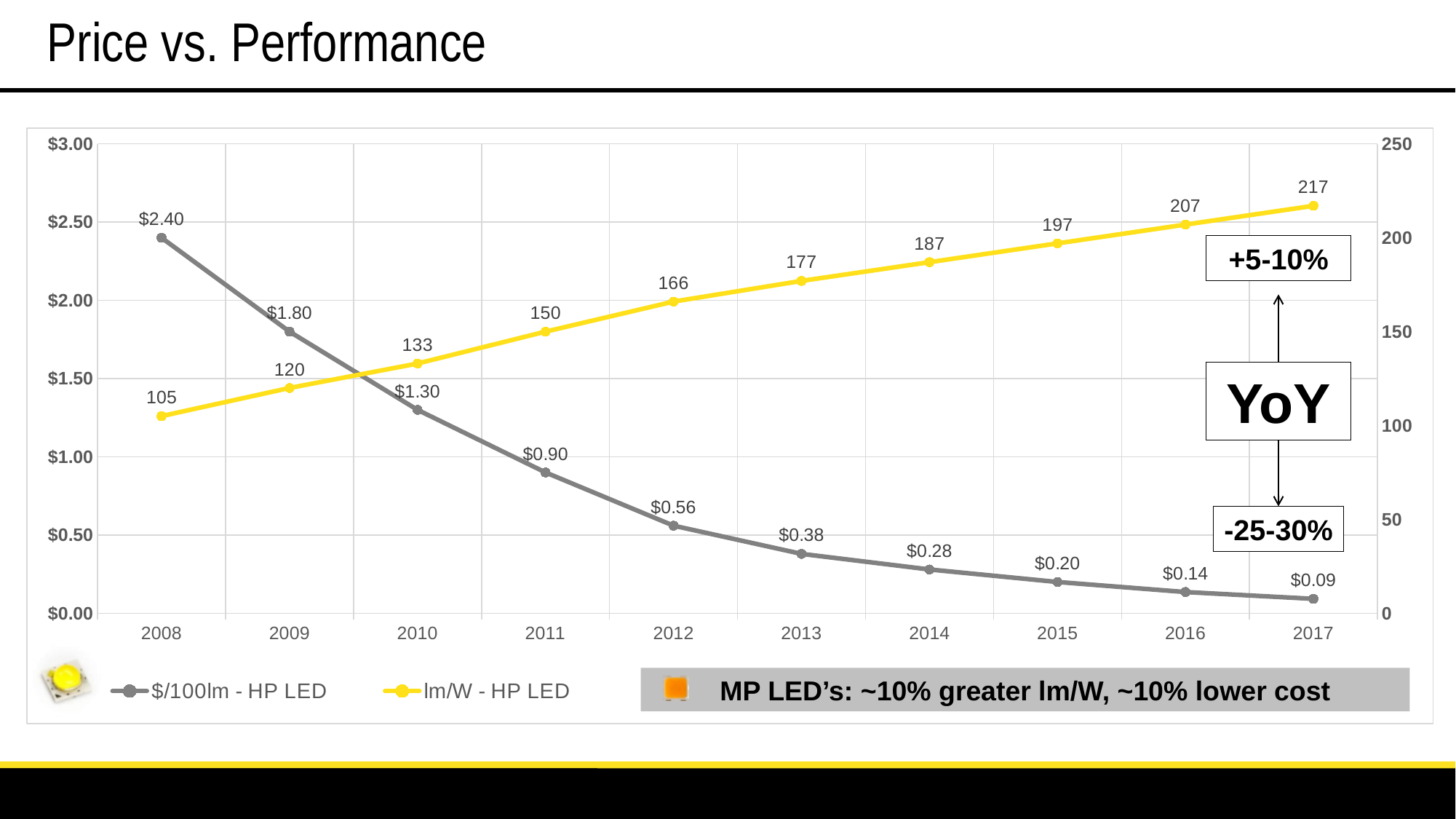
What is the difference between the $/100lm - HP LED values for 2009 and 2010? $0.50 In which year is the lm/W - HP LED value highest? 2017 What kind of chart is shown on the slide? Line chart In which year is the $/100lm - HP LED value lowest? 2017 What is the difference between the lm/W - HP LED values for 2017 and 2008? 112 What is the $/100lm - HP LED value for 2008? $2.40 What is the lm/W - HP LED value for 2013? 177 What is the $/100lm - HP LED value for 2017? $0.09 How many years are shown on the x axis? 10 Does the $/100lm - HP LED series rise or fall from 2008 to 2017? Fall How many series does the legend list? 2 Which year has a higher lm/W - HP LED value, 2011 or 2014? 2014